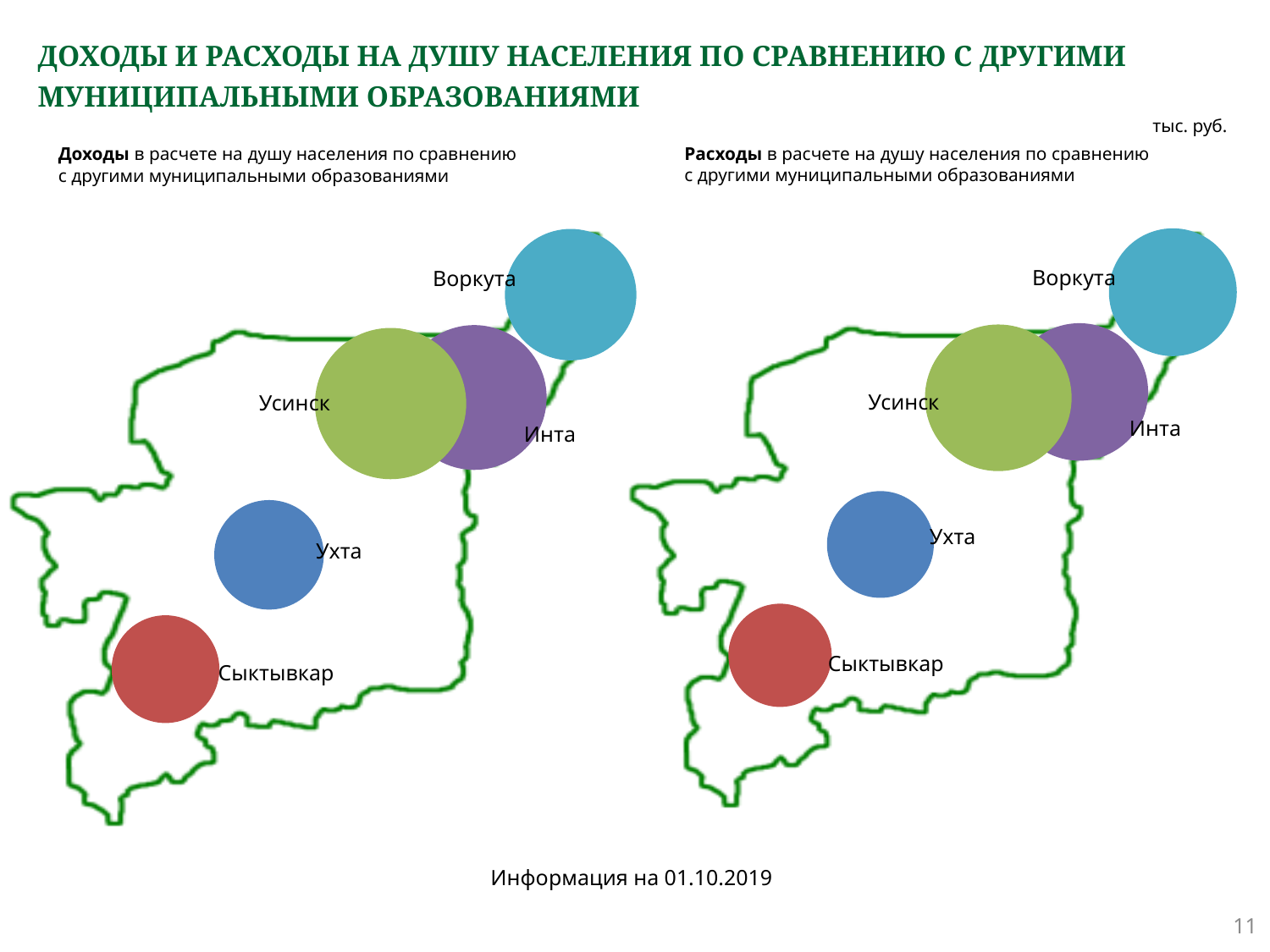
What colour is the bubble for Сыктывкар on both charts? Red What kind of chart is used on the right (Расходы) to compare municipalities? Bubble chart On the right chart (Расходы), which municipality has the largest bubble? Усинск On the left chart (Доходы), which bubble is larger: Усинск or Сыктывкар? Усинск On the left chart (Доходы), which municipality has the largest bubble? Усинск What unit is stated for the values on the slide? тыс. руб. How many municipalities are shown as bubbles on the left chart (Доходы)? 5 What kind of chart is used on the left (Доходы) to compare municipalities? Bubble chart On the right chart (Расходы), which bubble is larger: Воркута or Ухта? Воркута How many municipalities are shown as bubbles on the right chart (Расходы)? 5